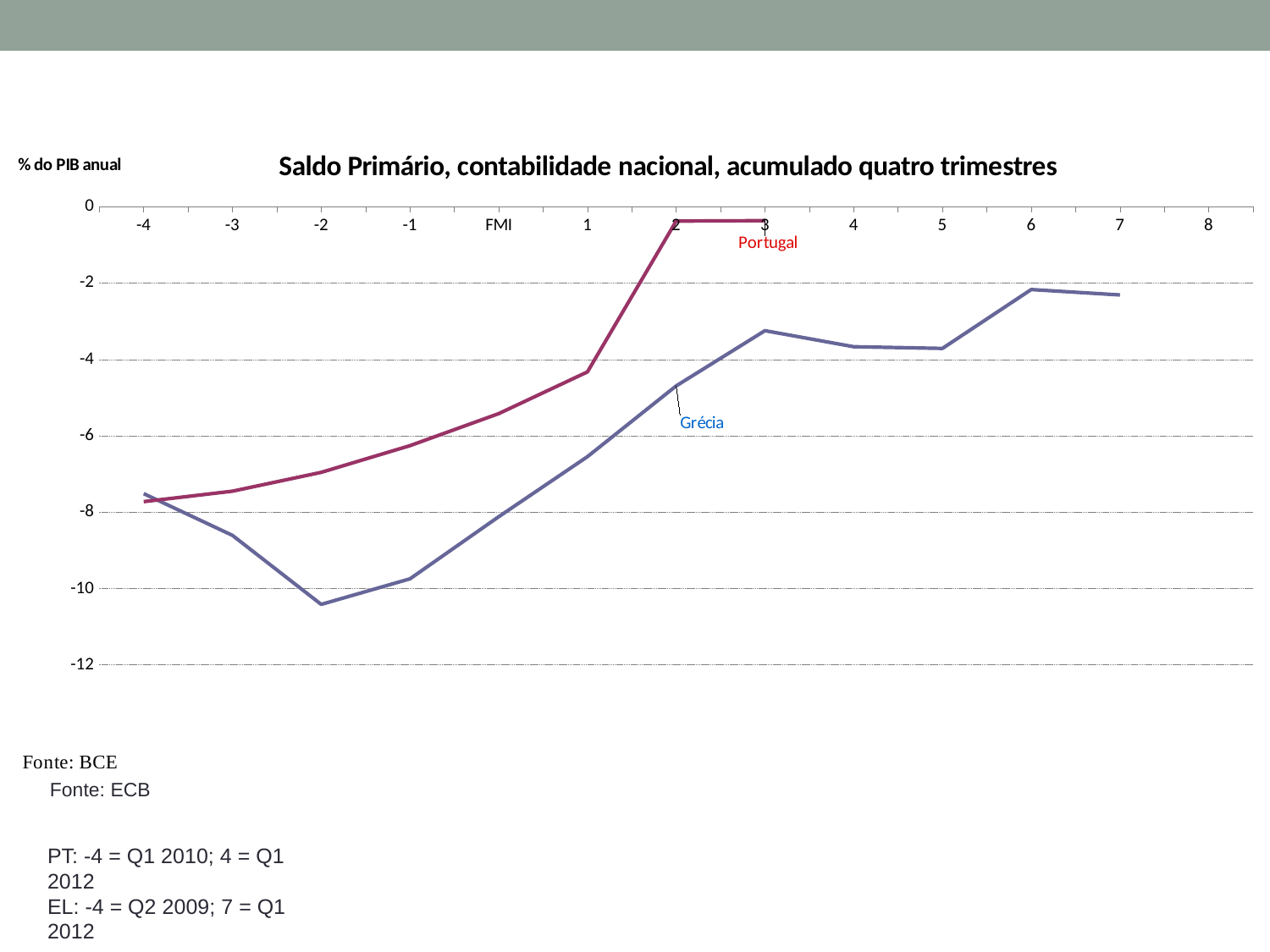
What kind of chart is shown on the slide? line chart Is the value for Grécia at x = 6 greater or less than -4? greater Is the value for Portugal at x = 1 greater or less than -6? greater Is the value for Grécia at x = 3 greater or less than -4? greater How many series are plotted on the chart? 2 At which x-axis point does the Grécia line reach its lowest value? -2 What unit label is shown at the top left of the chart's vertical axis? % do PIB anual What is the title of the chart? Saldo Primário, contabilidade nacional, acumulado quatro trimestres At x = 2, which series has the higher value, Portugal or Grécia? Portugal Does the Portugal line rise or fall as it moves from x = -4 to x = 3? rise